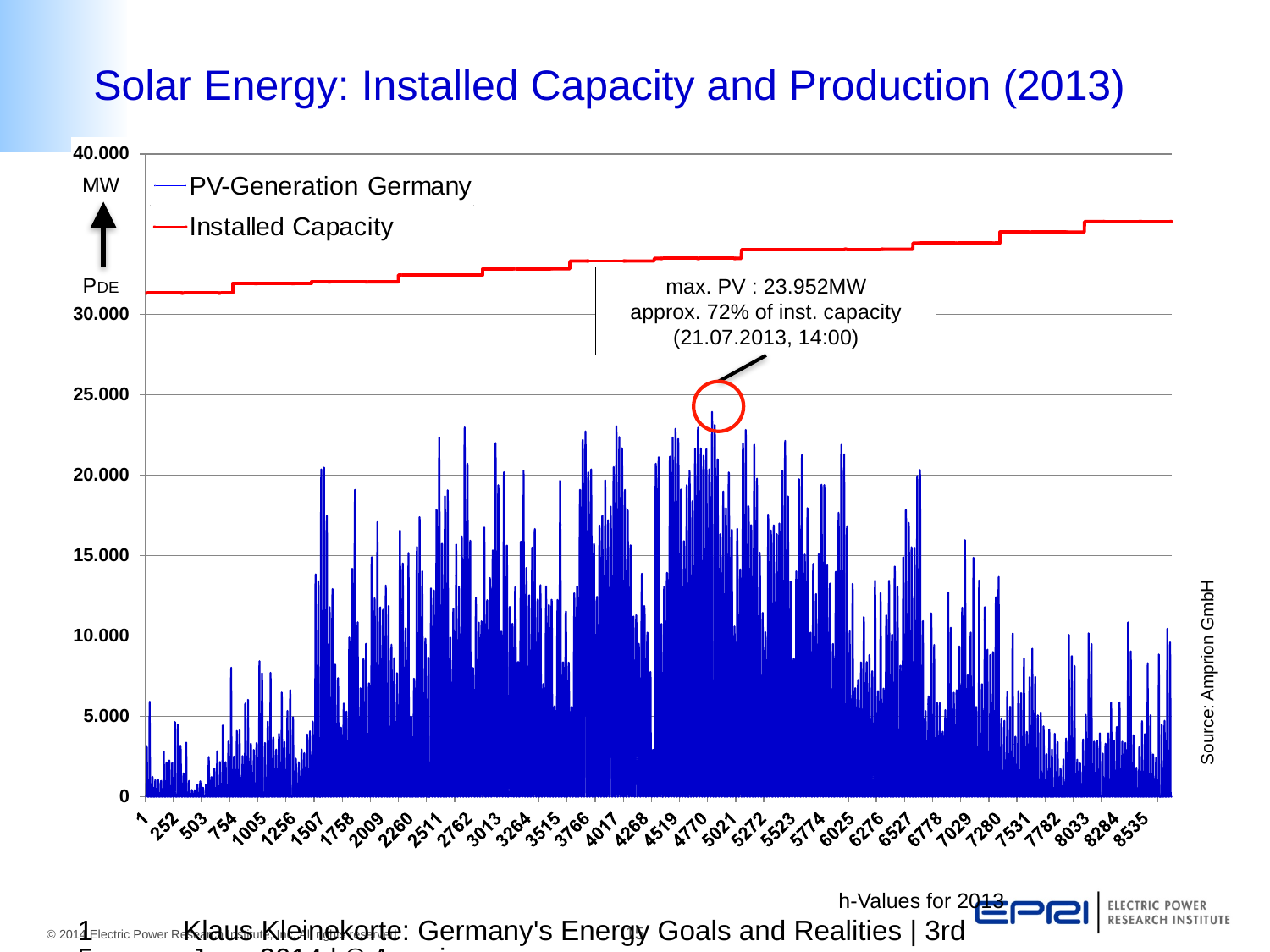
What are the two series named in the legend? PV-Generation Germany and Installed Capacity What is the maximum PV generation value annotated on the chart? 23.952MW How many series does the legend list? 2 What is the last tick label on the x axis? 8535 What unit is shown on the y axis? MW Is the Installed Capacity at the start of the year greater or less than 30.000 MW? greater Which series has the higher values throughout the year, Installed Capacity or PV-Generation Germany? Installed Capacity Is the maximum PV generation greater or less than 25.000 MW? less On what date and time did the annotated maximum PV generation occur? 21.07.2013, 14:00 According to the annotation, what share of installed capacity did the maximum PV generation represent? approx. 72% What is the highest value shown on the y axis? 40.000 Does the Installed Capacity line rise or fall along the x axis? rise